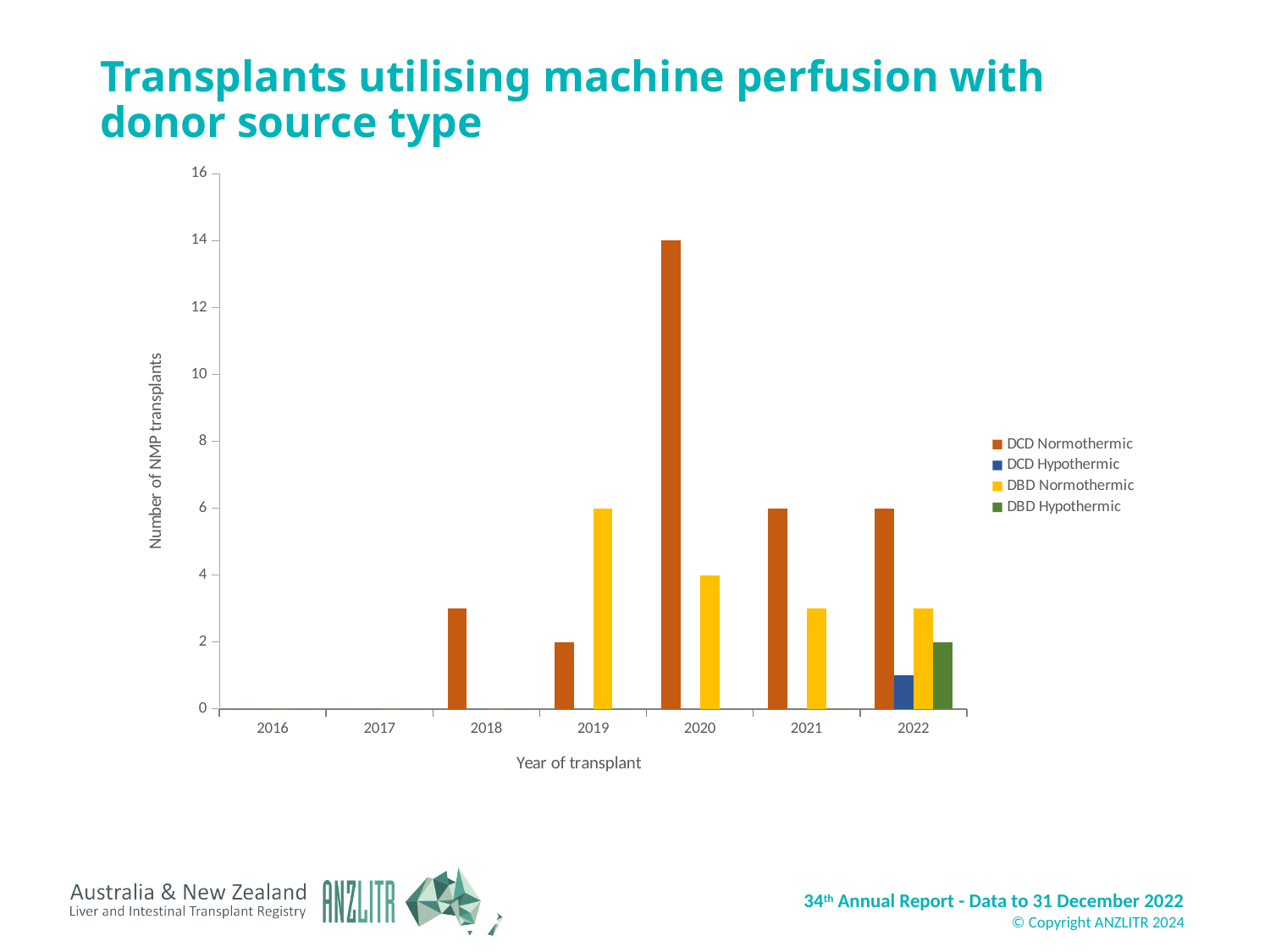
In which year is the DCD Normothermic bar highest? 2020 In 2019, which is larger: DCD Normothermic or DBD Normothermic? DBD Normothermic What is the number of DCD Normothermic NMP transplants in 2020? 14 What is the number of DBD Normothermic NMP transplants in 2019? 6 What is the number of DBD Hypothermic NMP transplants in 2022? 2 How many years are shown on the x axis? 7 How many series does the legend list? 4 What is the difference between DCD Normothermic and DBD Normothermic transplants in 2020? 10 Is the value for DCD Hypothermic in 2022 greater or less than 2? less Do DBD Normothermic transplants rise or fall from 2019 to 2021? fall What type of chart is shown on the slide? bar chart What is the number of DBD Normothermic NMP transplants in 2020? 4